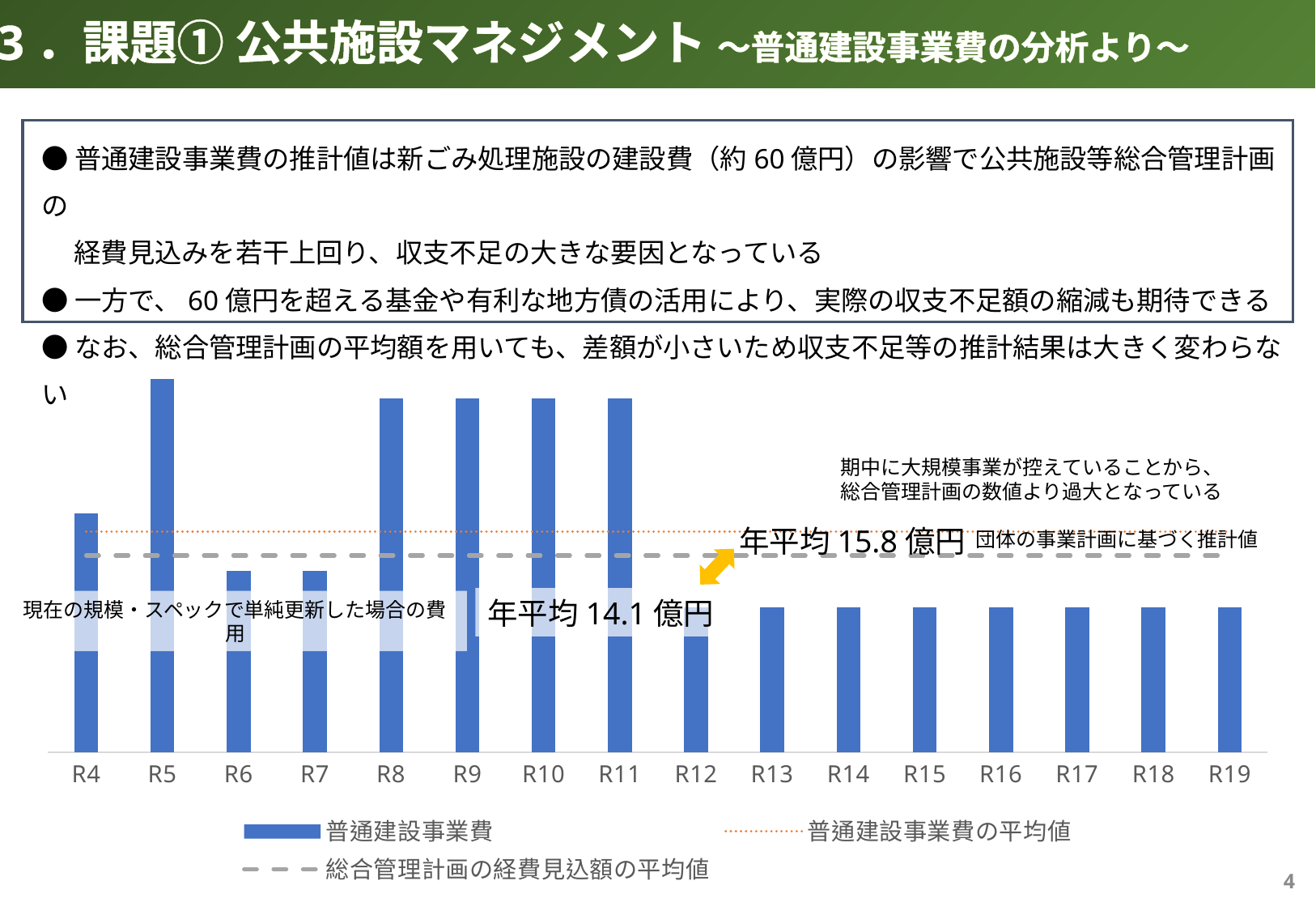
Which bar is taller, R5 or R8? R5 What is the difference between the two annual averages shown on the chart (15.8 億円 and 14.1 億円)? 1.7 億円 What kind of chart is shown on the slide? bar chart What is the annual average of 総合管理計画の経費見込額 shown on the chart? 年平均 14.1 億円 What is the annual average of 普通建設事業費 shown on the chart? 年平均 15.8 億円 How many categories (years) are shown on the x axis of the chart? 16 How many entries does the chart's legend list? 3 Which legend entry is drawn as a gray dashed line? 総合管理計画の経費見込額の平均値 Do the bars rise, fall, or stay flat from R13 to R19? stay flat Which year has the highest 普通建設事業費 bar? R5 Which bar is taller, R4 or R6? R4